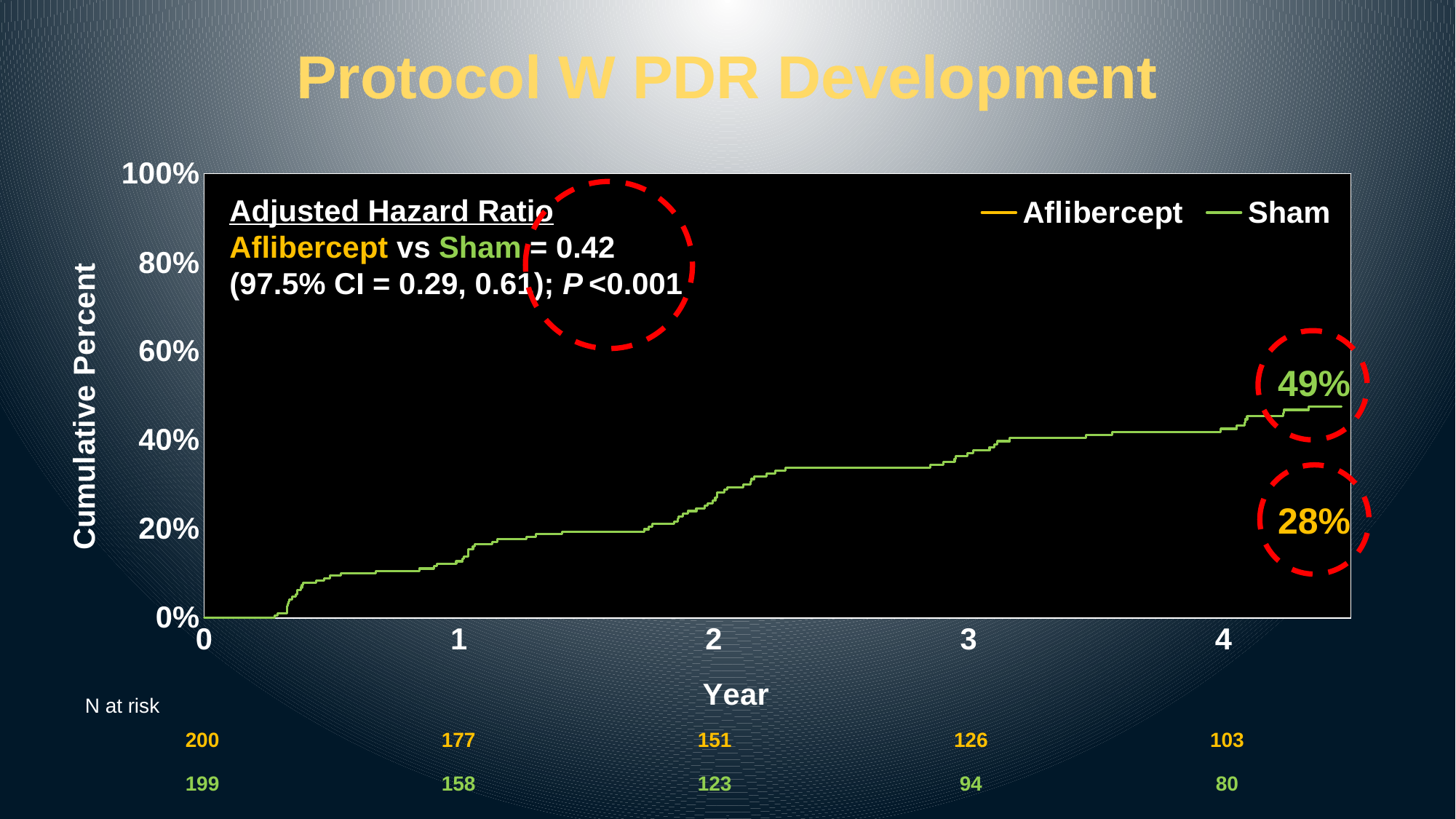
Does the Sham curve rise or fall as Year increases? rises What is the final cumulative percent labelled for the Aflibercept group? 28% What is the title of the chart? Protocol W PDR Development In the N at risk table, how many Sham participants are at risk at Year 4? 80 What is the final cumulative percent labelled for the Sham group? 49% What kind of chart is shown on the slide? line chart How many series does the legend list? 2 Is the cumulative percent for Sham at Year 2 greater or less than 40%? less What is the adjusted hazard ratio for Aflibercept vs Sham shown on the chart? 0.42 Which group has the higher labelled final cumulative percent, Aflibercept or Sham? Sham What is the difference between the labelled final cumulative percents for Sham and Aflibercept? 21% Is the cumulative percent for Sham at Year 1 greater or less than 20%? less